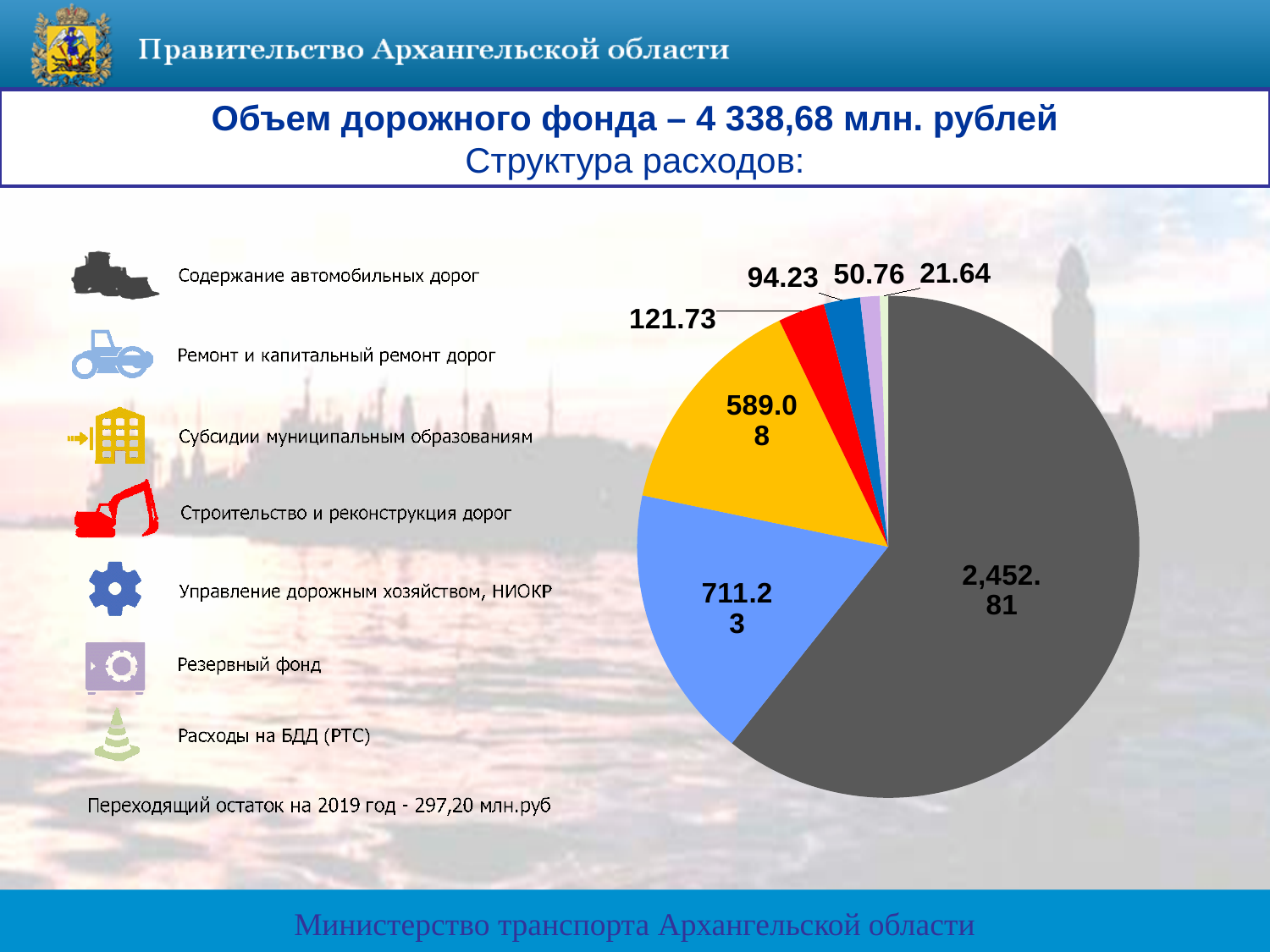
Which category has the largest slice of the pie? Содержание автомобильных дорог What type of chart is shown on the slide? pie chart What is the value of the slice for Ремонт и капитальный ремонт дорог? 711.23 What is the value of the slice for Содержание автомобильных дорог? 2,452.81 What is the value of the slice for Расходы на БДД (РТС)? 21.64 What is the value of the slice for Строительство и реконструкция дорог? 121.73 What colour is the slice for Строительство и реконструкция дорог? red Which category has the smallest slice of the pie? Расходы на БДД (РТС) What is the value of the slice for Субсидии муниципальным образованиям? 589.08 How many slices does the pie chart have? 7 Which is larger: the value for Управление дорожным хозяйством, НИОКР or the value for Резервный фонд? Управление дорожным хозяйством, НИОКР What is the difference between the values for Ремонт и капитальный ремонт дорог and Субсидии муниципальным образованиям? 122.15